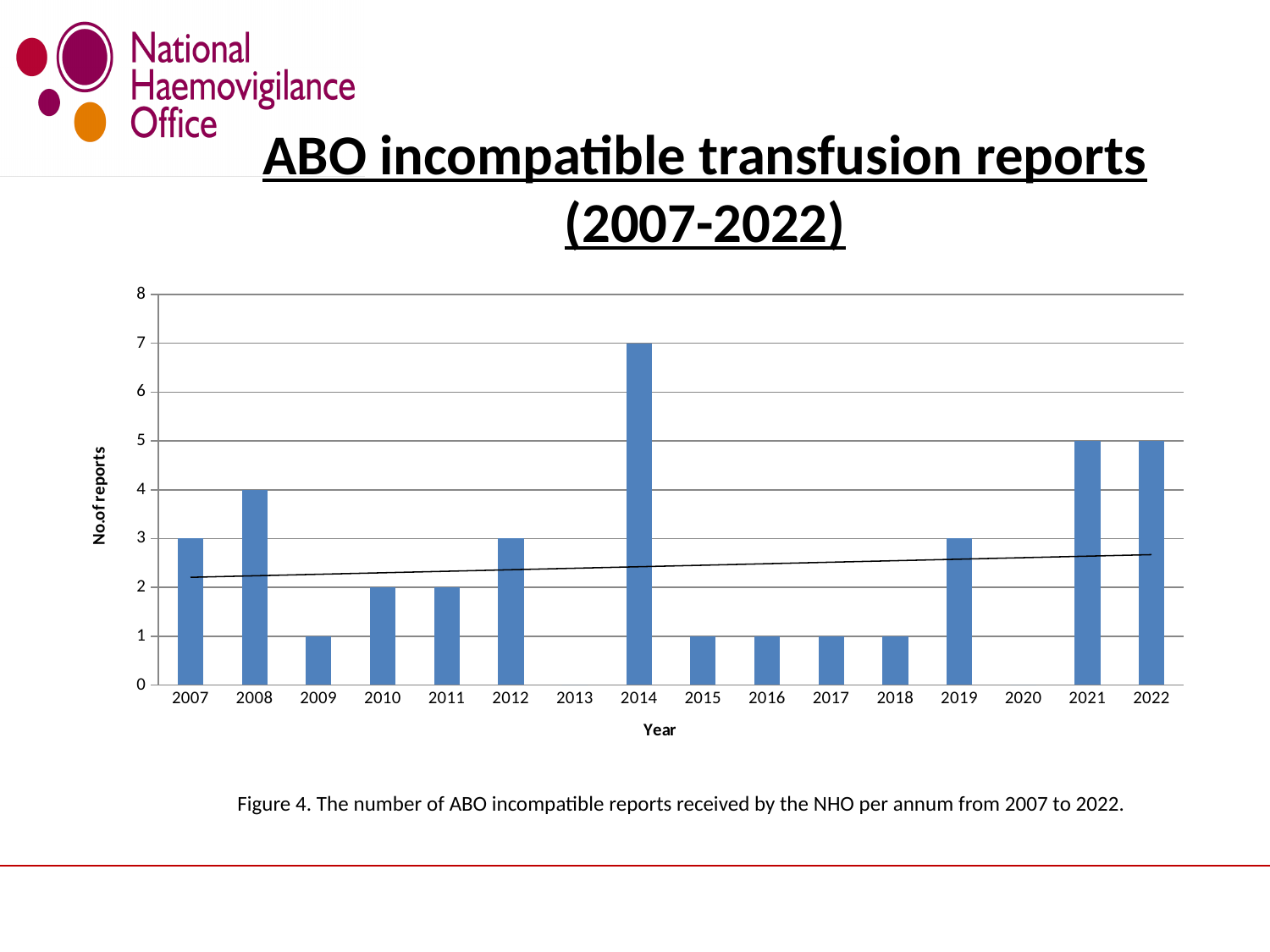
What kind of chart is shown on the slide? Bar chart Which year has the highest number of ABO incompatible reports? 2014 What is the difference between the number of reports in 2014 and in 2008? 3 What is the number of ABO incompatible reports in 2021? 5 Do the values rise or fall from 2008 to 2009? Fall Is the value for 2014 greater or less than 6? greater Which year has more ABO incompatible reports, 2007 or 2010? 2007 What is the number of ABO incompatible reports in 2008? 4 How many years are shown on the x axis of the chart? 16 What is the label of the y axis of the chart? No.of reports What is the label of the x axis of the chart? Year What is the number of ABO incompatible reports in 2014? 7